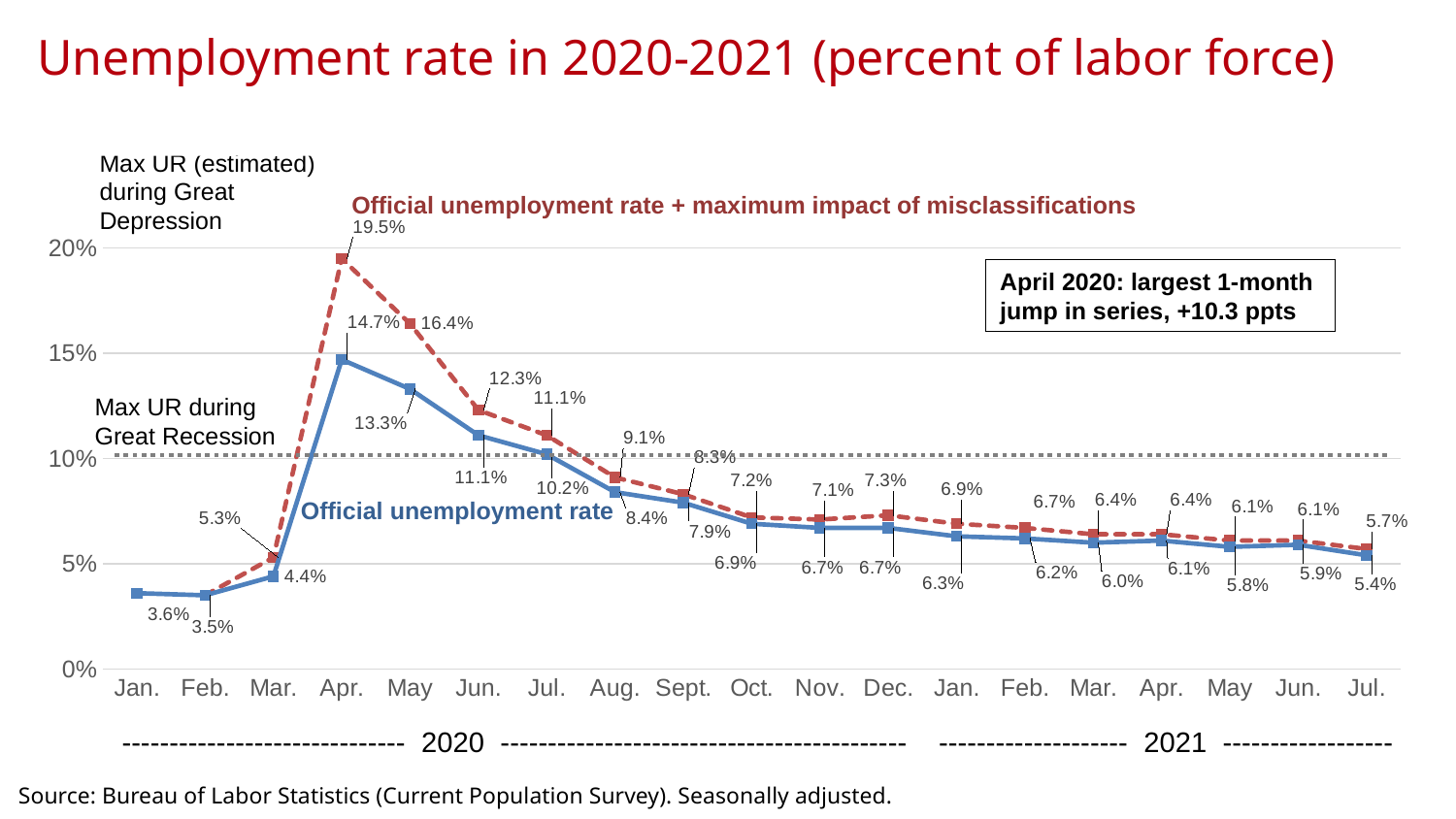
What was the official unemployment rate plus maximum impact of misclassifications in April 2020? 19.5% In which month was the official unemployment rate lowest? February 2020 How many data series are plotted on the chart? 2 How many months are plotted on the x axis? 19 By how many percentage points did the official unemployment rate rise from March 2020 to April 2020? 10.3 percentage points From April 2020 to July 2021, does the official unemployment rate generally rise or fall? fall What was the official unemployment rate in July 2021? 5.4% How many percentage points higher was the official unemployment rate plus maximum impact of misclassifications than the official unemployment rate in April 2020? 4.8 percentage points What kind of chart is shown on the slide? line chart In which month did the official unemployment rate reach its highest value? April 2020 What was the official unemployment rate in April 2020? 14.7% Which was higher, the official unemployment rate in May 2020 or in June 2020? May 2020